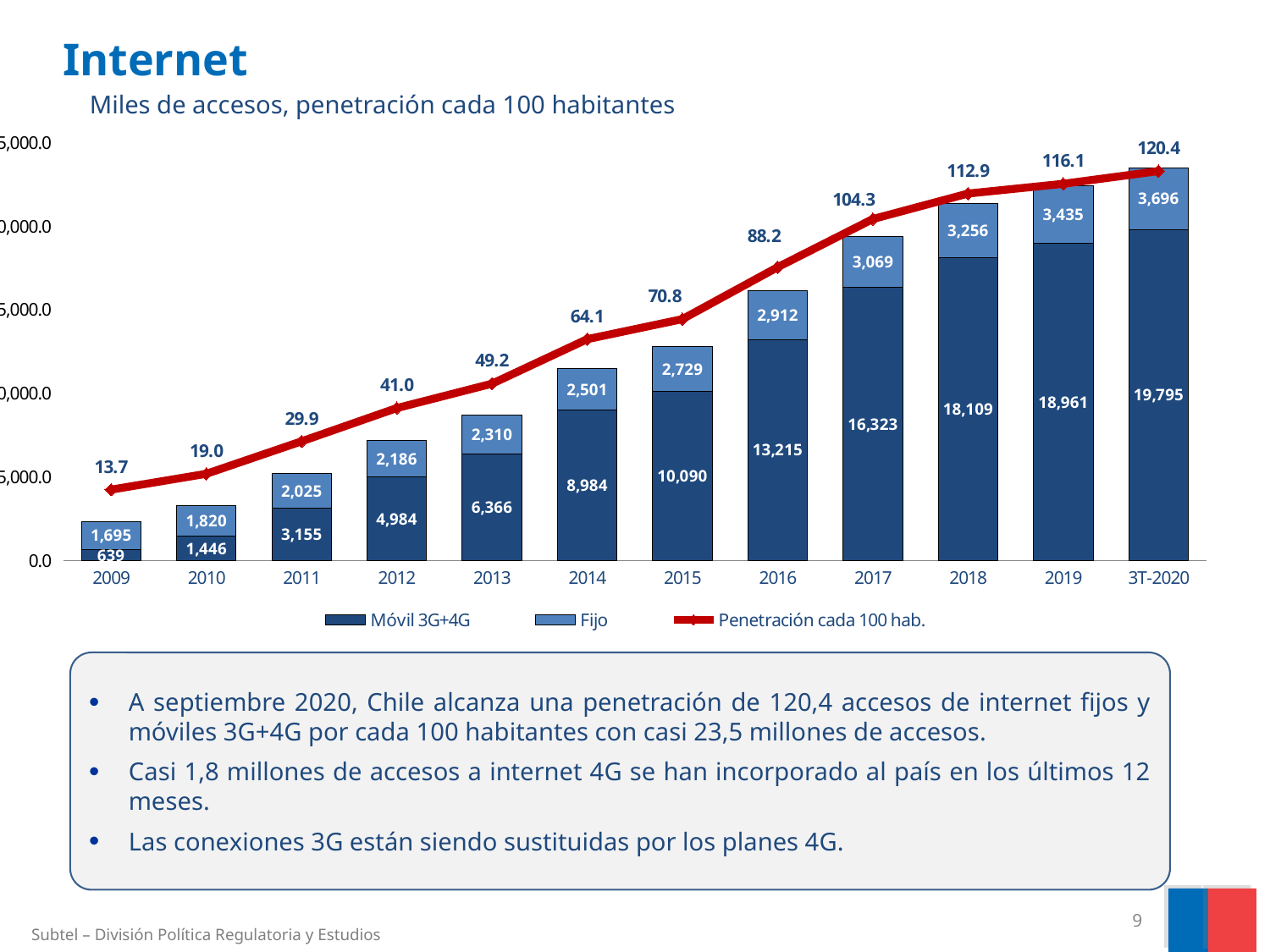
What is the total of the stacked bar for 3T-2020 (Móvil 3G+4G plus Fijo)? 23,491 What is the Penetración cada 100 hab. value for 2017? 104.3 What is the Fijo value for 2013? 2,310 How many categories are shown on the x axis? 12 What kind of chart is this? Stacked bar chart with a line Which category has the highest Penetración cada 100 hab. value? 3T-2020 How many series does the legend list? 3 What is the difference between the Móvil 3G+4G values for 3T-2020 and 2019? 834 What is the Móvil 3G+4G value for 2016? 13,215 Which is larger in 2010, the Móvil 3G+4G value or the Fijo value? Fijo Which year has the lowest Móvil 3G+4G value? 2009 Does the Penetración cada 100 hab. line rise or fall from 2009 to 3T-2020? Rise